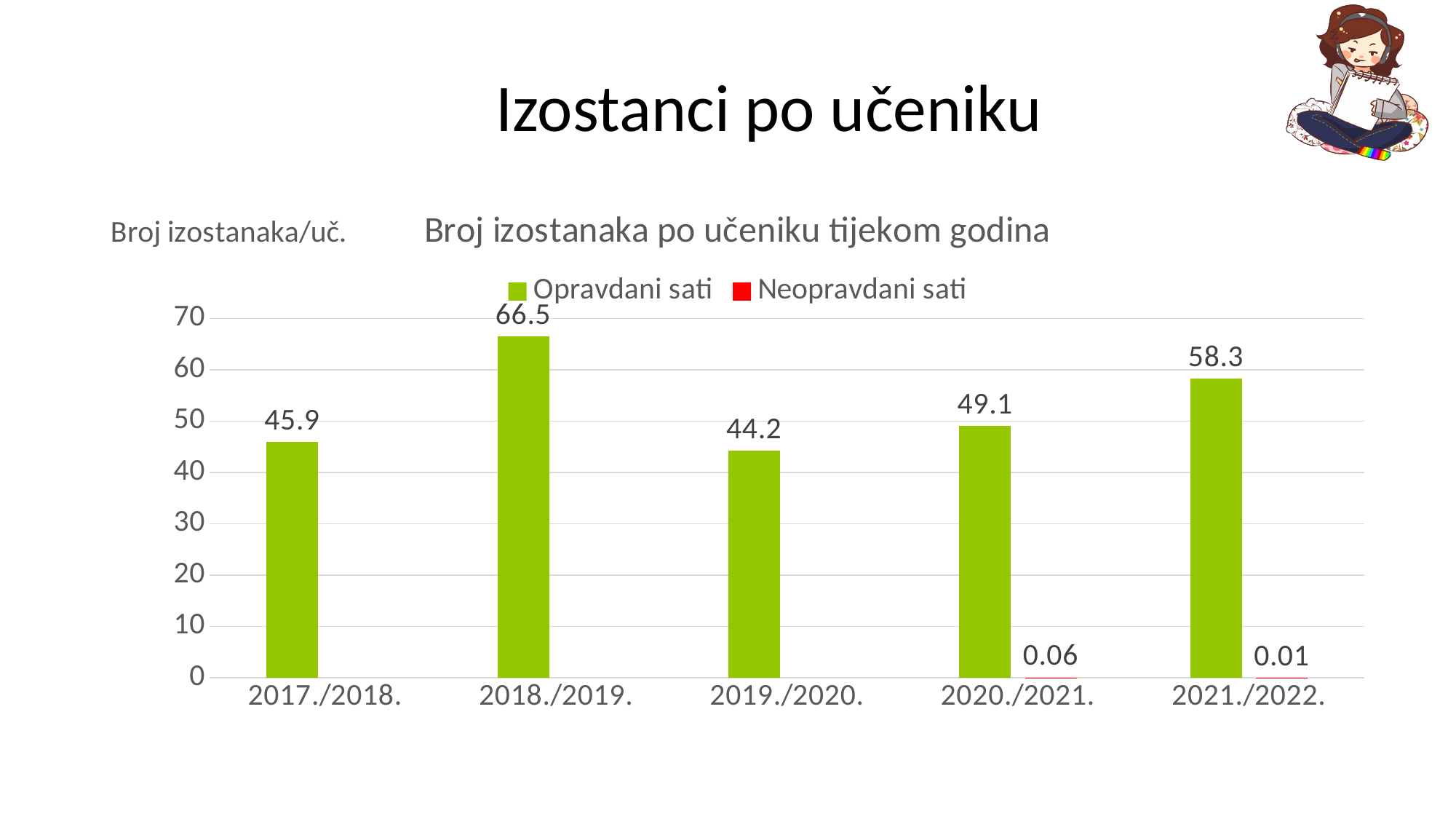
Is the Opravdani sati value for 2021./2022. greater or less than 50? greater What is the value of Neopravdani sati for 2020./2021.? 0.06 Which school year has the highest value of Opravdani sati? 2018./2019. What is the value of Opravdani sati for 2018./2019.? 66.5 Which is larger, the Opravdani sati value for 2020./2021. or for 2021./2022.? 2021./2022. What is the difference between the Opravdani sati values for 2018./2019. and 2019./2020.? 22.3 What type of chart is shown on the slide? bar chart How many series does the legend list? 2 What is the value of Opravdani sati for 2017./2018.? 45.9 What is the value of Neopravdani sati for 2021./2022.? 0.01 How many school years are shown on the x axis? 5 Which school year has the lowest value of Opravdani sati? 2019./2020.